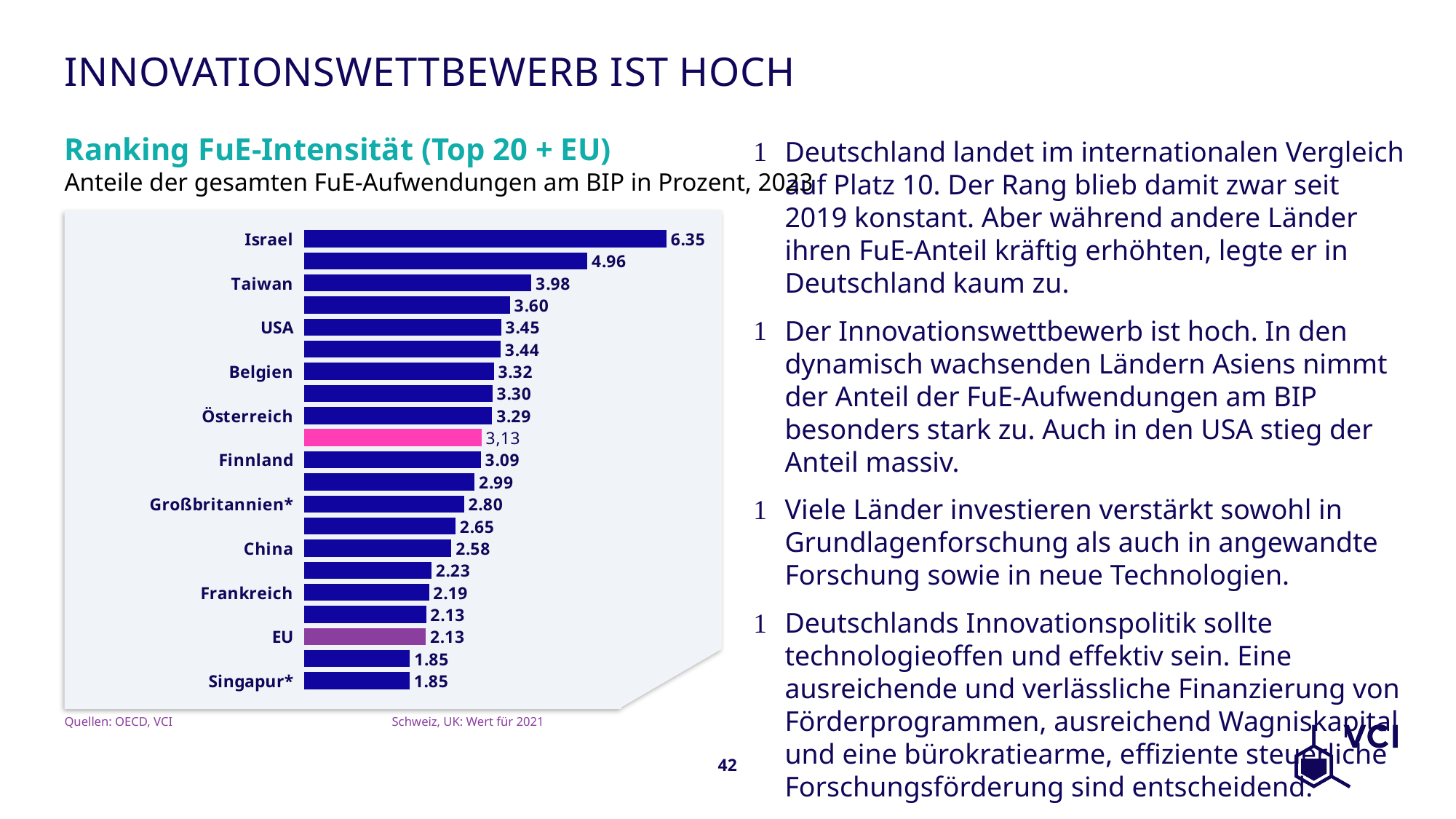
What is the difference between the values for Israel and Taiwan? 2.37 What is the value for China? 2.58 What is the value for the USA? 3.45 What kind of chart is shown on the slide? Bar chart What is the value for Israel? 6.35 Which is larger, the value for the USA or the value for Belgien? USA What is the lowest value shown in the chart? 1.85 What is the value for the EU? 2.13 What is the value for Taiwan? 3.98 How many bars are shown in the chart? 21 Which country has the highest value in the chart? Israel What value is shown on the pink highlighted bar? 3,13